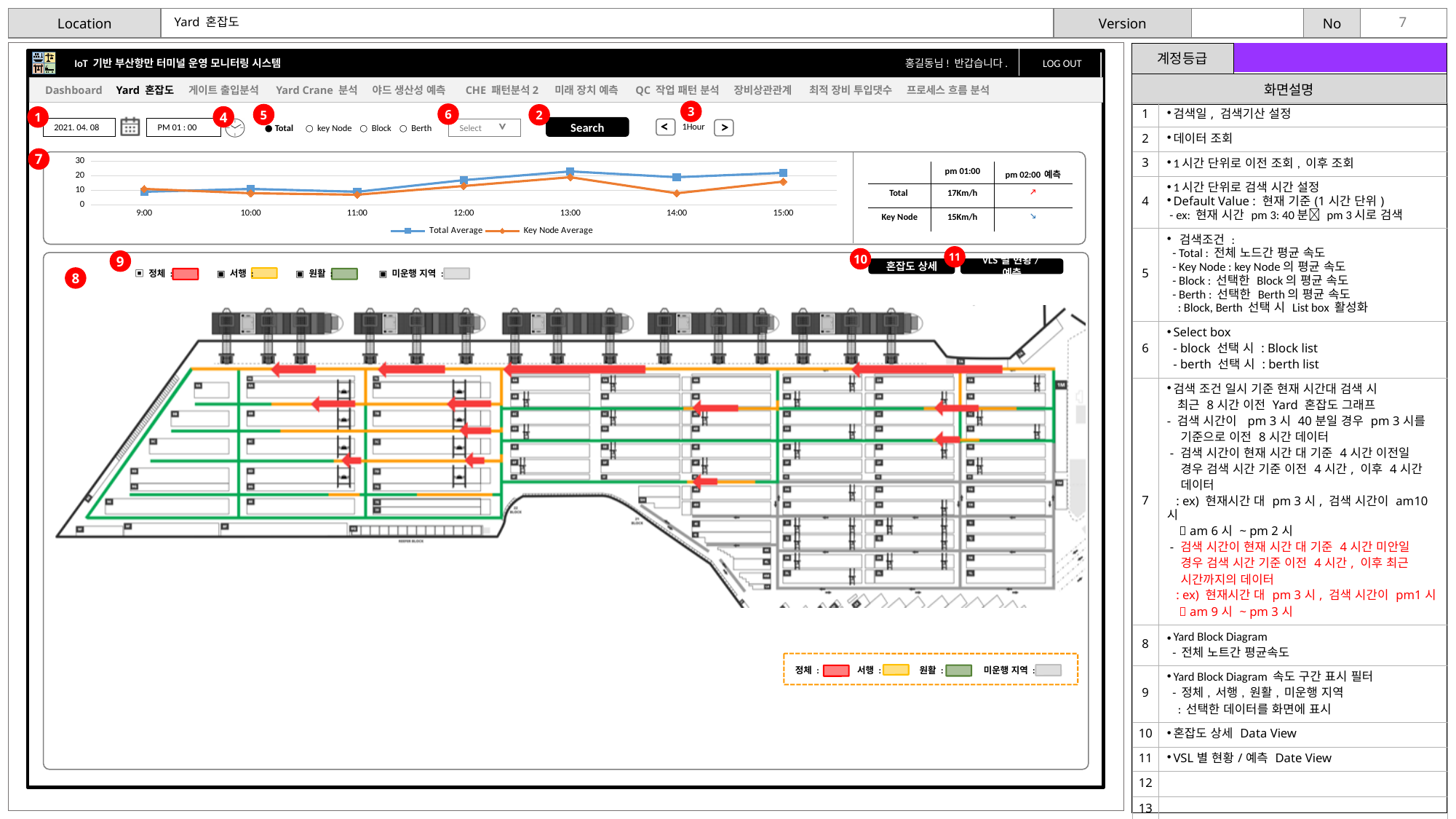
What kind of chart is shown at the top of the screen mock-up? line chart At which time does the Key Node Average series reach its highest value? 13:00 Does the Total Average series rise or fall between 11:00 and 13:00? rise Does the Key Node Average series rise or fall between 13:00 and 14:00? fall How many time points are plotted along the x axis of the line chart? 7 Is the Key Node Average value at 11:00 greater or less than 10? less Is the Total Average value at 12:00 greater or less than 10? greater Is the Total Average value at 13:00 greater or less than 20? greater At 14:00, which series has the larger value, Total Average or Key Node Average? Total Average How many series does the legend of the line chart list? 2 What are the two series named in the line chart's legend? Total Average and Key Node Average